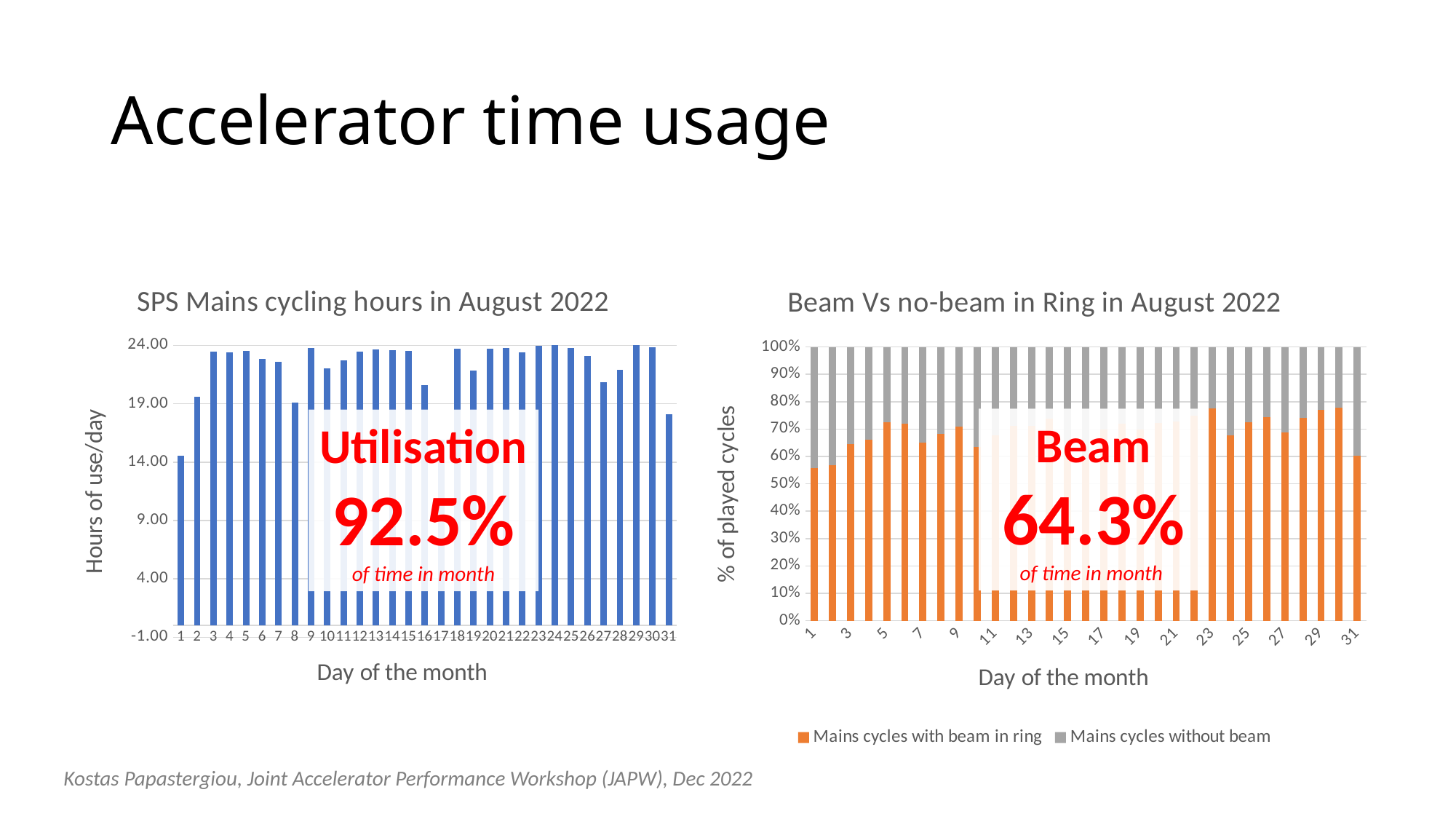
What kind of chart is the 'Beam Vs no-beam in Ring in August 2022' chart? stacked bar chart In the 'SPS Mains cycling hours in August 2022' chart, is the value for day 31 greater or less than 19.00? less What utilisation percentage of time in the month is highlighted on the 'SPS Mains cycling hours in August 2022' chart? 92.5% How many series does the legend of the 'Beam Vs no-beam in Ring in August 2022' chart list? 2 In the 'SPS Mains cycling hours in August 2022' chart, how many days are plotted on the x axis? 31 In the 'SPS Mains cycling hours in August 2022' chart, is the value for day 16 greater or less than 19.00? greater In the 'SPS Mains cycling hours in August 2022' chart, which day has the lowest hours of use? 1 What kind of chart is the 'SPS Mains cycling hours in August 2022' chart? bar chart In the 'Beam Vs no-beam in Ring in August 2022' chart, is the 'Mains cycles with beam in ring' share for day 11 greater or less than 20%? greater In the 'Beam Vs no-beam in Ring in August 2022' chart, what is the total of each stacked bar? 100%